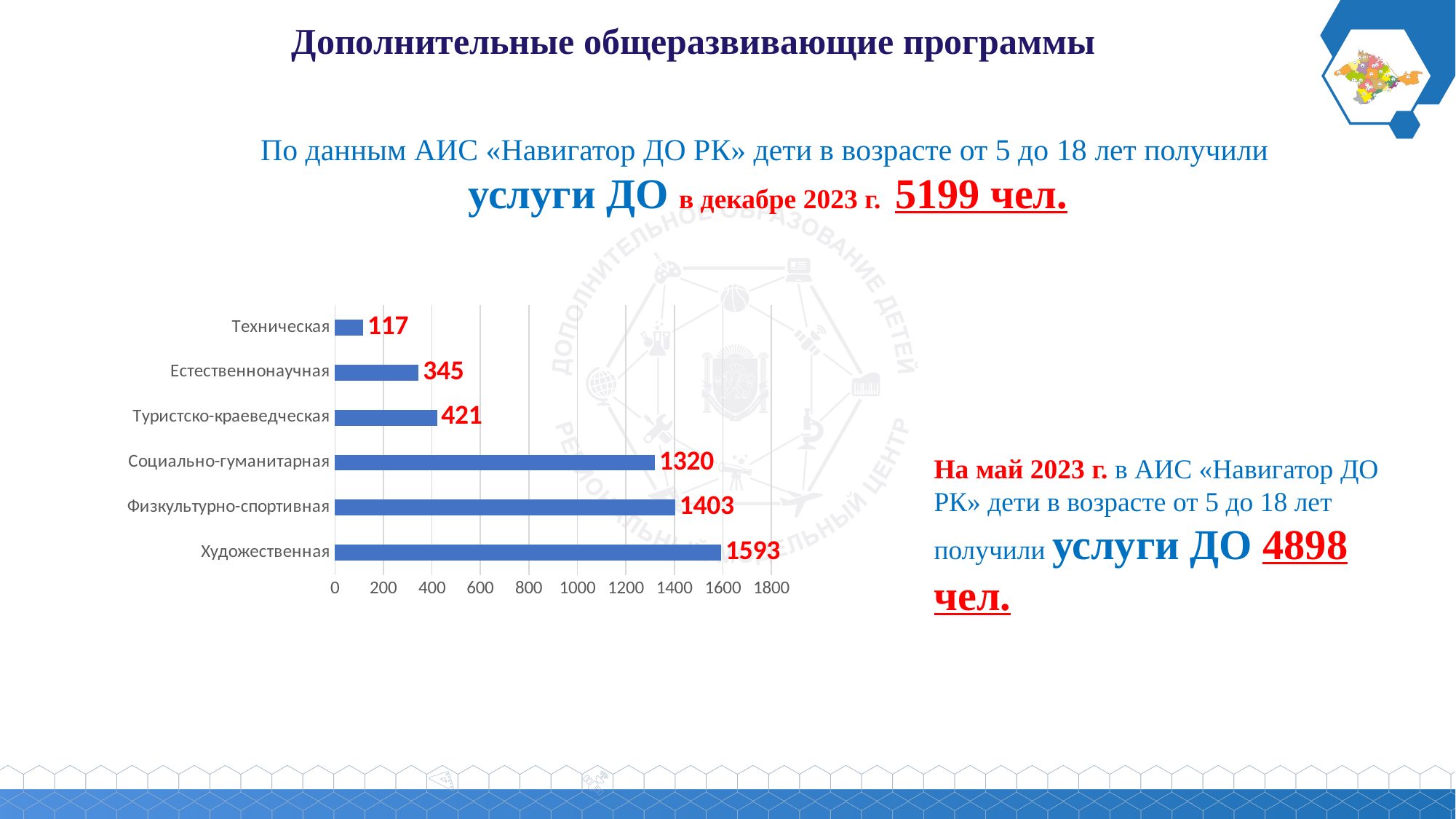
What is the value for Художественная? 1593 Which is larger, the value for Естественнонаучная or the value for Туристско-краеведческая? Туристско-краеведческая What is the value for Социально-гуманитарная? 1320 How many categories are shown in the chart? 6 What is the value for Техническая? 117 What is the difference between the values for Физкультурно-спортивная and Социально-гуманитарная? 83 Which category has the highest value? Художественная Which category has the lowest value? Техническая What is the difference between the values for Туристско-краеведческая and Естественнонаучная? 76 What kind of chart is shown on the slide? bar chart Is the value for Физкультурно-спортивная greater or less than 1200? greater What is the value for Туристско-краеведческая? 421